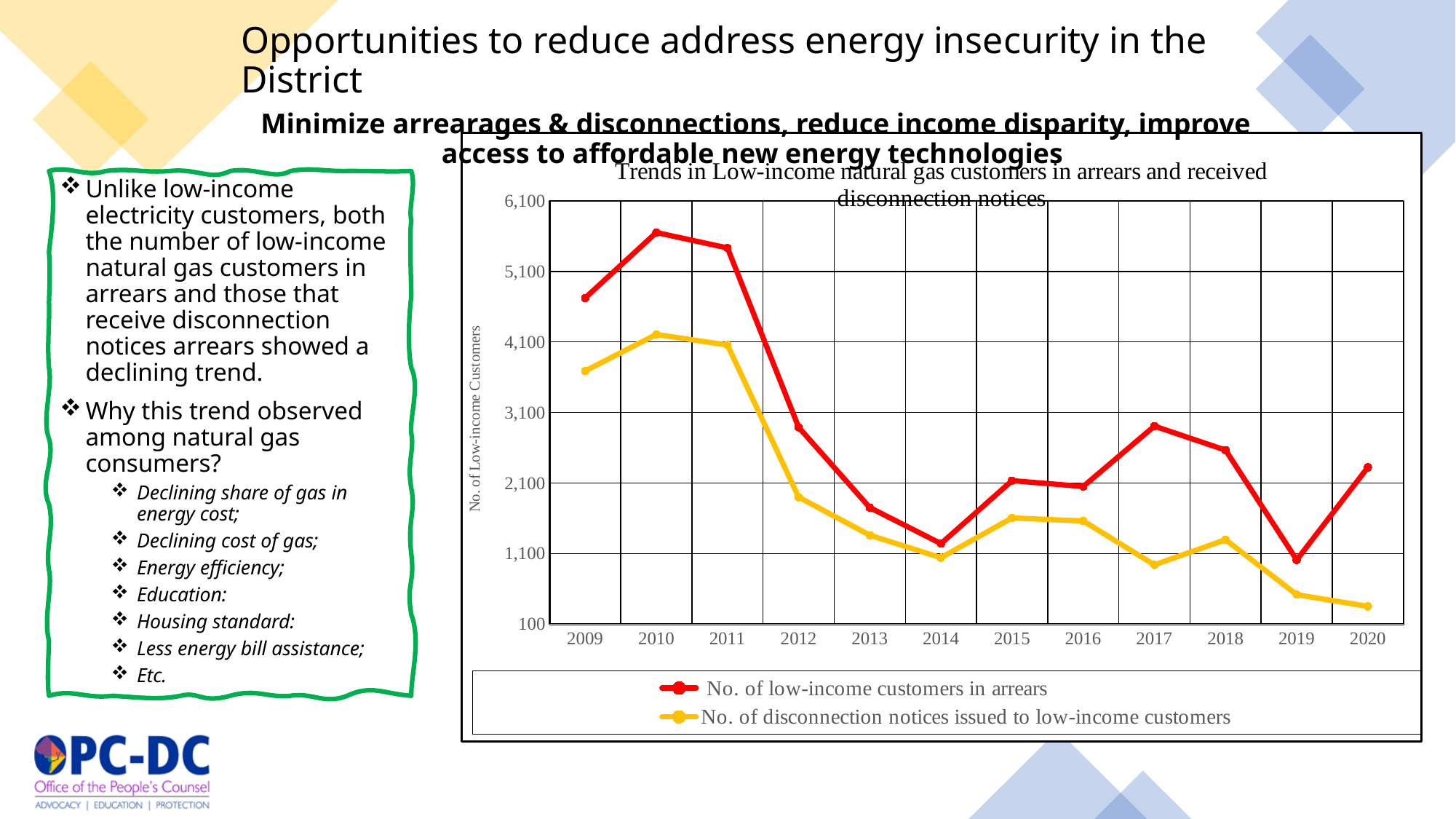
How many series does the chart legend list? 2 What type of chart is shown on the slide? Line chart Is the number of disconnection notices issued to low-income customers in 2020 greater or less than 1,100? less Which is larger in 2009: the number of low-income customers in arrears or the number of disconnection notices issued to low-income customers? No. of low-income customers in arrears Is the number of low-income customers in arrears in 2017 greater or less than 3,100? less Is the number of low-income customers in arrears in 2010 greater or less than 5,100? greater In which year is the number of low-income customers in arrears lowest? 2019 In which year is the number of disconnection notices issued to low-income customers lowest? 2020 How many years are plotted along the x axis of the chart? 12 Overall, do the number of disconnection notices issued to low-income customers rise or fall from 2009 to 2020? Fall In which year is the number of low-income customers in arrears highest? 2010 What colour is the line for the number of disconnection notices issued to low-income customers? Yellow